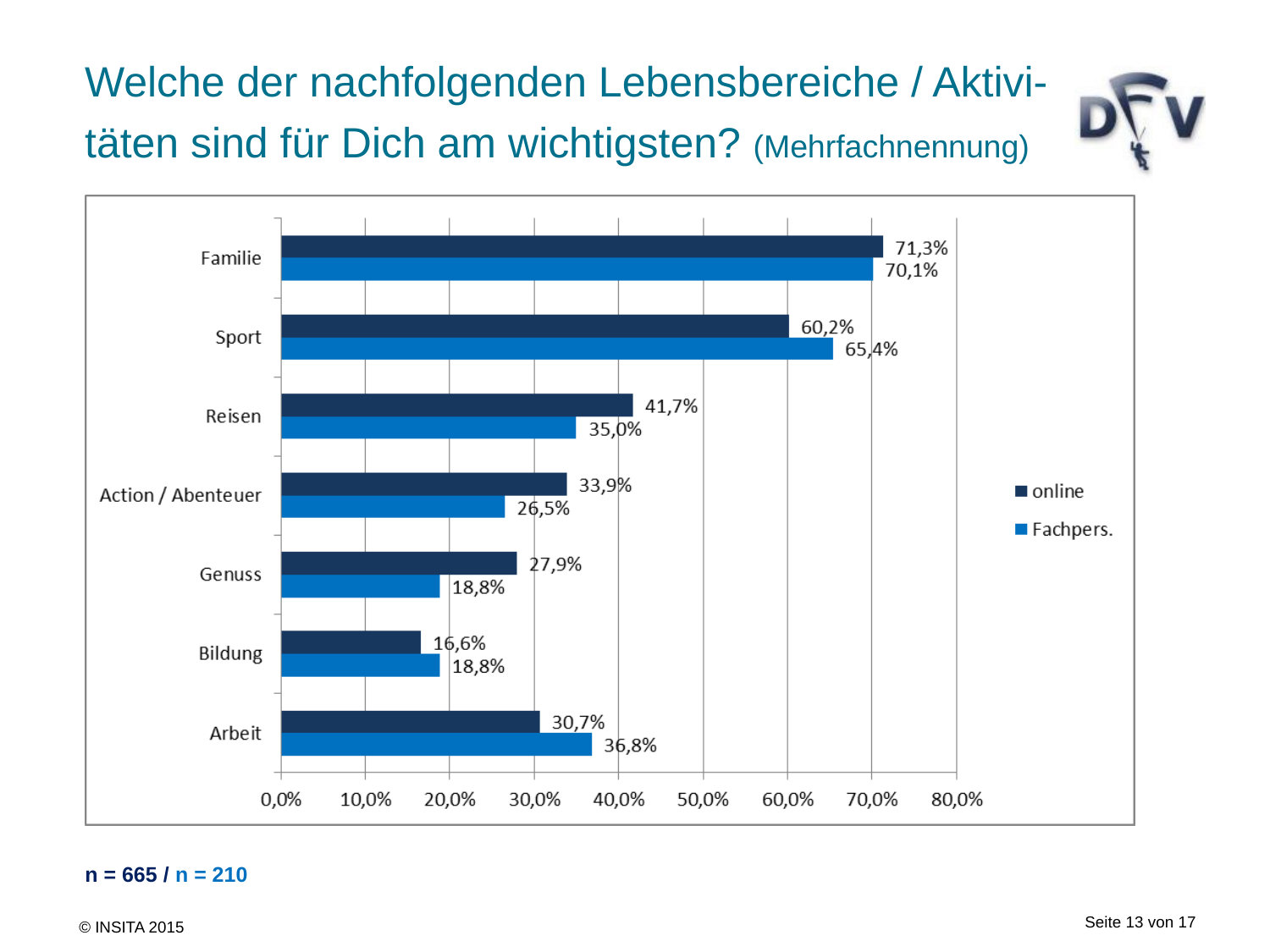
What are the two series named in the legend? online and Fachpers. What is the value for Arbeit in the online series? 30,7% What kind of chart is shown on the slide? bar chart Which category has the lowest value in the online series? Bildung For Arbeit, which series has the larger value, online or Fachpers.? Fachpers. What is the difference between the online and Fachpers. values for Reisen? 6,7% What is the value for Familie in the online series? 71,3% How many series does the legend list? 2 How many categories are shown on the chart? 7 For Genuss, which series has the larger value, online or Fachpers.? online What is the value for Sport in the Fachpers. series? 65,4% Which category has the highest value in the online series? Familie